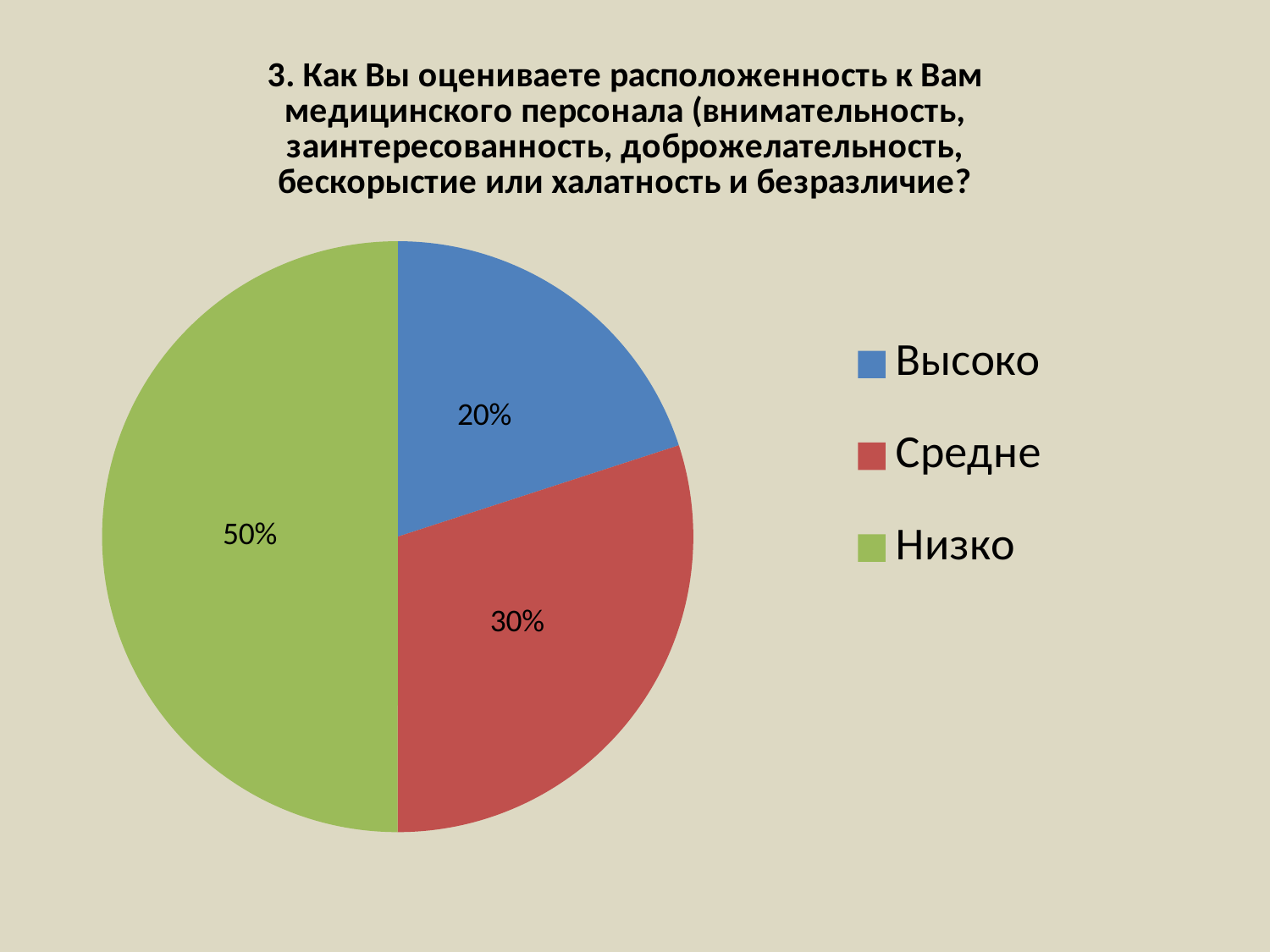
What is the difference between the values for Низко and Высоко? 30% What is the value for Высоко? 20% Which category has the largest slice? Низко How many slices does the pie chart have? 3 What colour is the slice for Средне? red How many entries does the legend list? 3 Which category has the smallest slice? Высоко What is the difference between the values for Средне and Высоко? 10% What share of the pie does Низко take? 50% What is the value for Средне? 30% Which is larger, the slice for Средне or the slice for Высоко? Средне What kind of chart is shown on the slide? pie chart